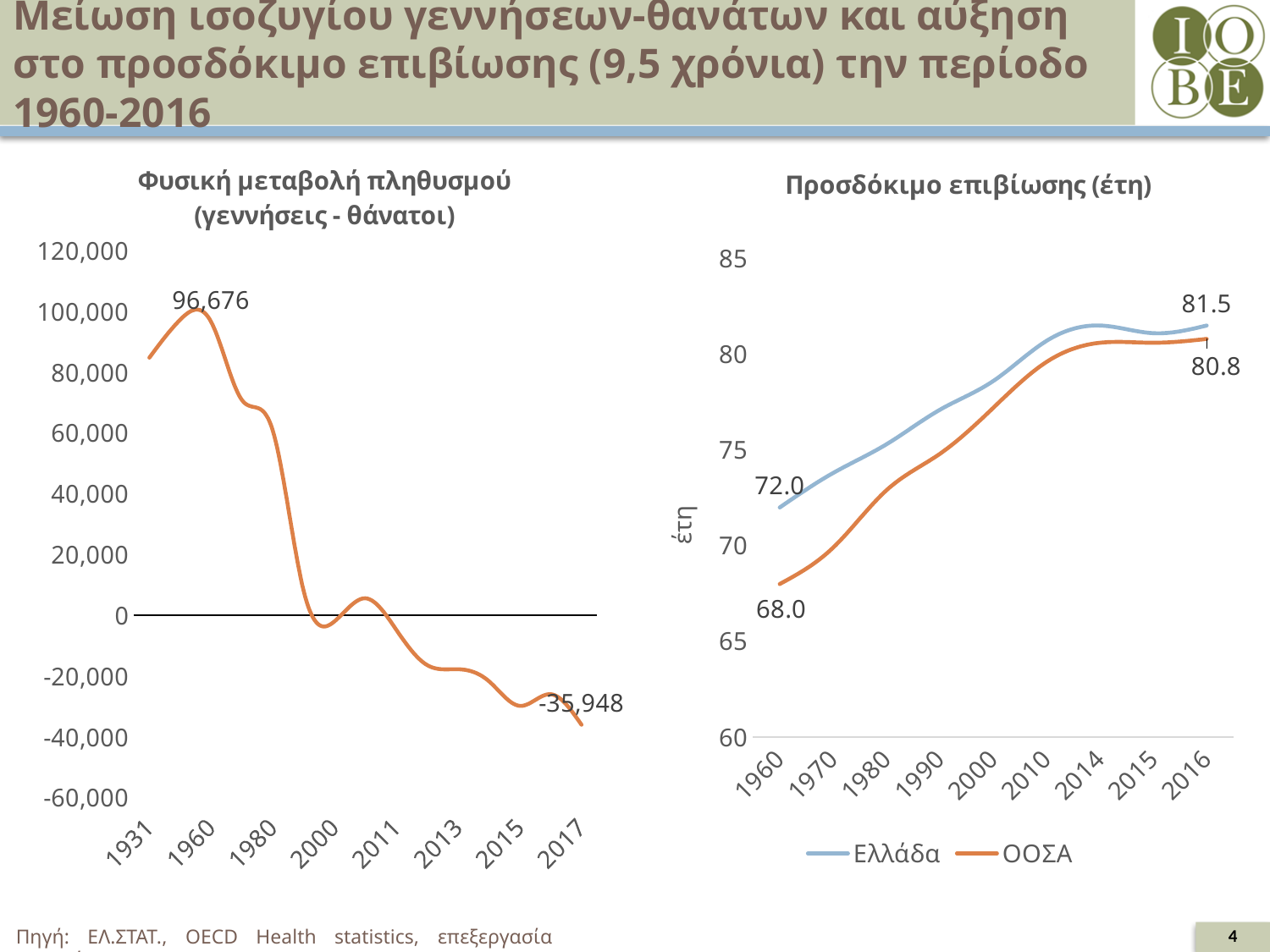
In the right chart 'Προσδόκιμο επιβίωσης (έτη)', by how much did the value for Ελλάδα increase from 1960 to 2016? 9.5 In the left chart 'Φυσική μεταβολή πληθυσμού', what is the value for 1960? 96,676 What kind of chart is the left chart, 'Φυσική μεταβολή πληθυσμού (γεννήσεις - θάνατοι)'? line chart In the right chart 'Προσδόκιμο επιβίωσης (έτη)', which series has the higher value in 2016, Ελλάδα or ΟΟΣΑ? Ελλάδα In the left chart 'Φυσική μεταβολή πληθυσμού', what is the value for 2017? -35,948 In the left chart 'Φυσική μεταβολή πληθυσμού', do the values overall rise or fall from 1960 to 2017? fall In the right chart 'Προσδόκιμο επιβίωσης (έτη)', what is the value for ΟΟΣΑ in 2016? 80.8 How many years are labelled on the x axis of the left chart 'Φυσική μεταβολή πληθυσμού'? 8 In the left chart 'Φυσική μεταβολή πληθυσμού', what is the difference between the 1960 value and the 2017 value? 132,624 In the right chart 'Προσδόκιμο επιβίωσης (έτη)', what is the value for Ελλάδα in 1960? 72.0 In the right chart 'Προσδόκιμο επιβίωσης (έτη)', is the value for ΟΟΣΑ in 1980 greater or less than 75? less How many series does the legend of the right chart 'Προσδόκιμο επιβίωσης (έτη)' list? 2